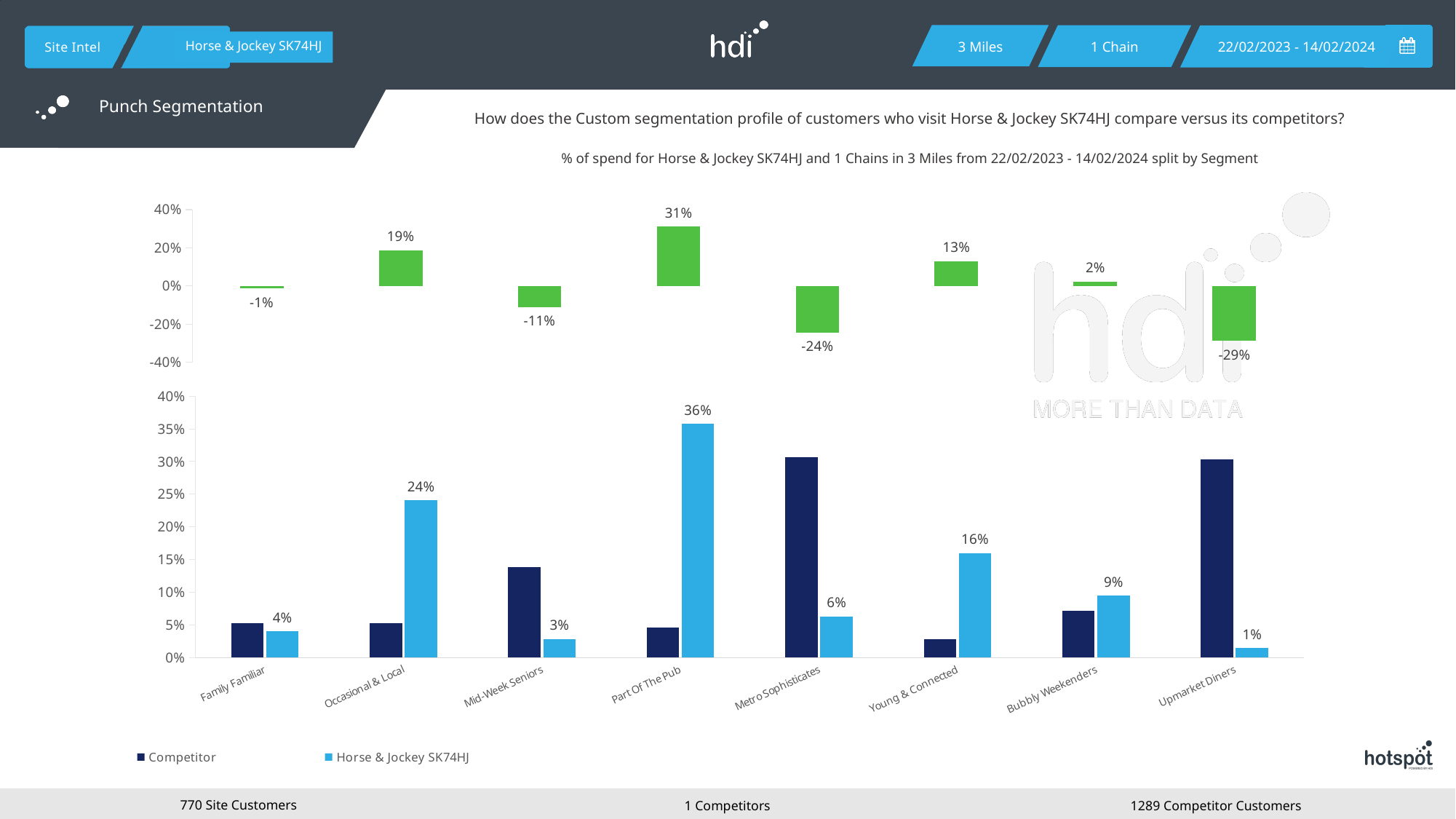
In the bottom chart, what is the value for Horse & Jockey SK74HJ in the Part Of The Pub segment? 36% In the top chart, which segment has the lowest value? Upmarket Diners In the bottom chart, for Metro Sophisticates, which series has the larger value: Competitor or Horse & Jockey SK74HJ? Competitor In the bottom chart's legend, which series is shown in dark navy blue? Competitor What kind of chart is the bottom chart? Bar chart In the top chart, what is the value for Metro Sophisticates? -24% In the bottom chart, what is the difference between the Horse & Jockey SK74HJ values for Occasional & Local and Young & Connected? 8 percentage points In the bottom chart, which segment has the lowest value for Horse & Jockey SK74HJ? Upmarket Diners How many segments are shown on the x axis of the bottom chart? 8 In the bottom chart, is the Competitor value for Upmarket Diners greater or less than 20%? greater In the top chart, which segment has the highest value? Part Of The Pub How many series does the legend of the bottom chart list? 2